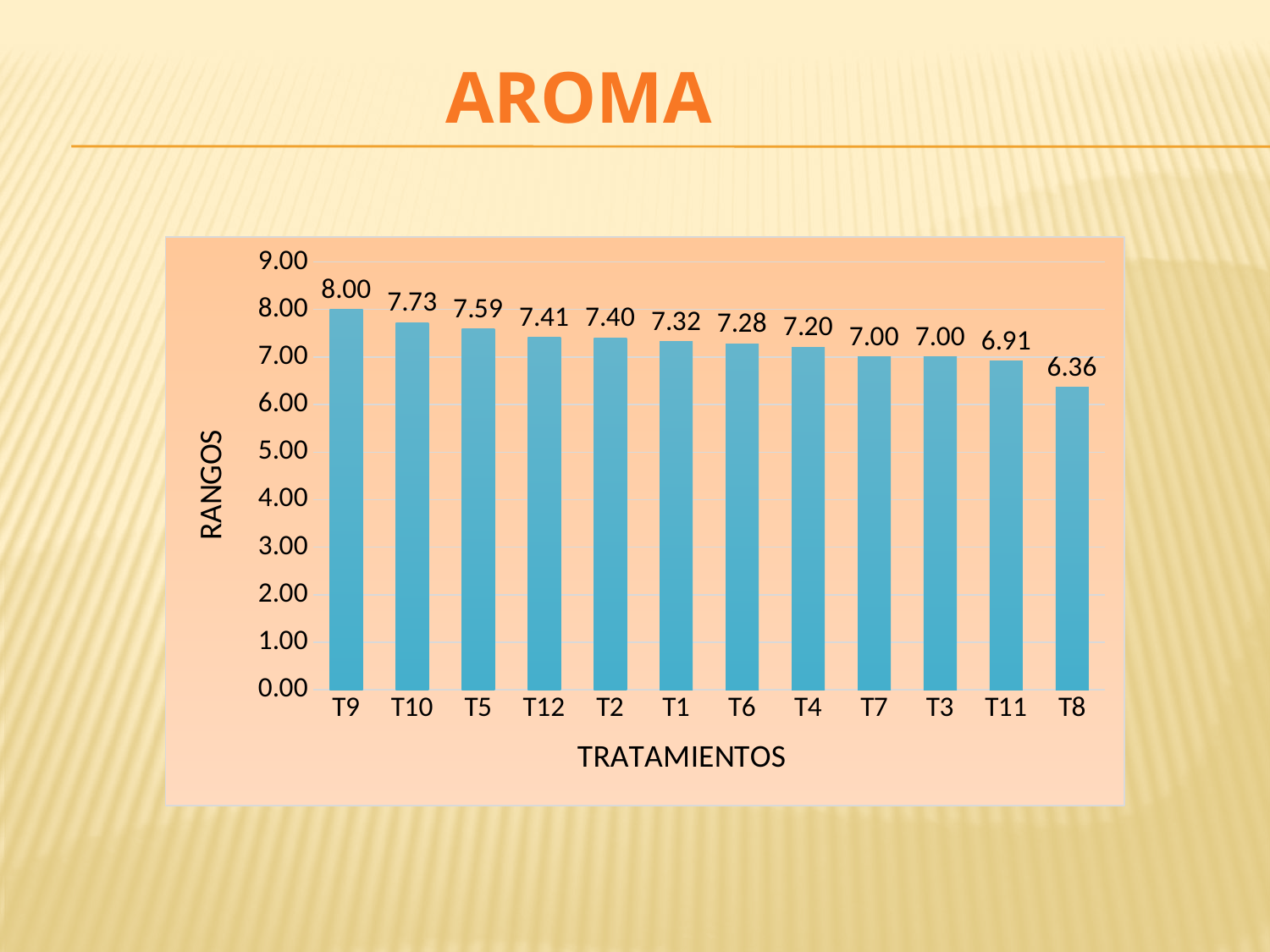
How many treatments are shown on the x axis? 12 Which treatment has the lowest value? T8 Do the values rise or fall from left to right along the x axis? Fall What is the value for T12? 7.41 Which has a larger value, T4 or T11? T4 What is the value for T9? 8.00 What is the value for T11? 6.91 What is the difference between the values for T10 and T5? 0.14 Which treatment has the highest value? T9 What is the difference between the values for T9 and T8? 1.64 What kind of chart is shown on the slide? Bar chart What is the label of the y axis? RANGOS